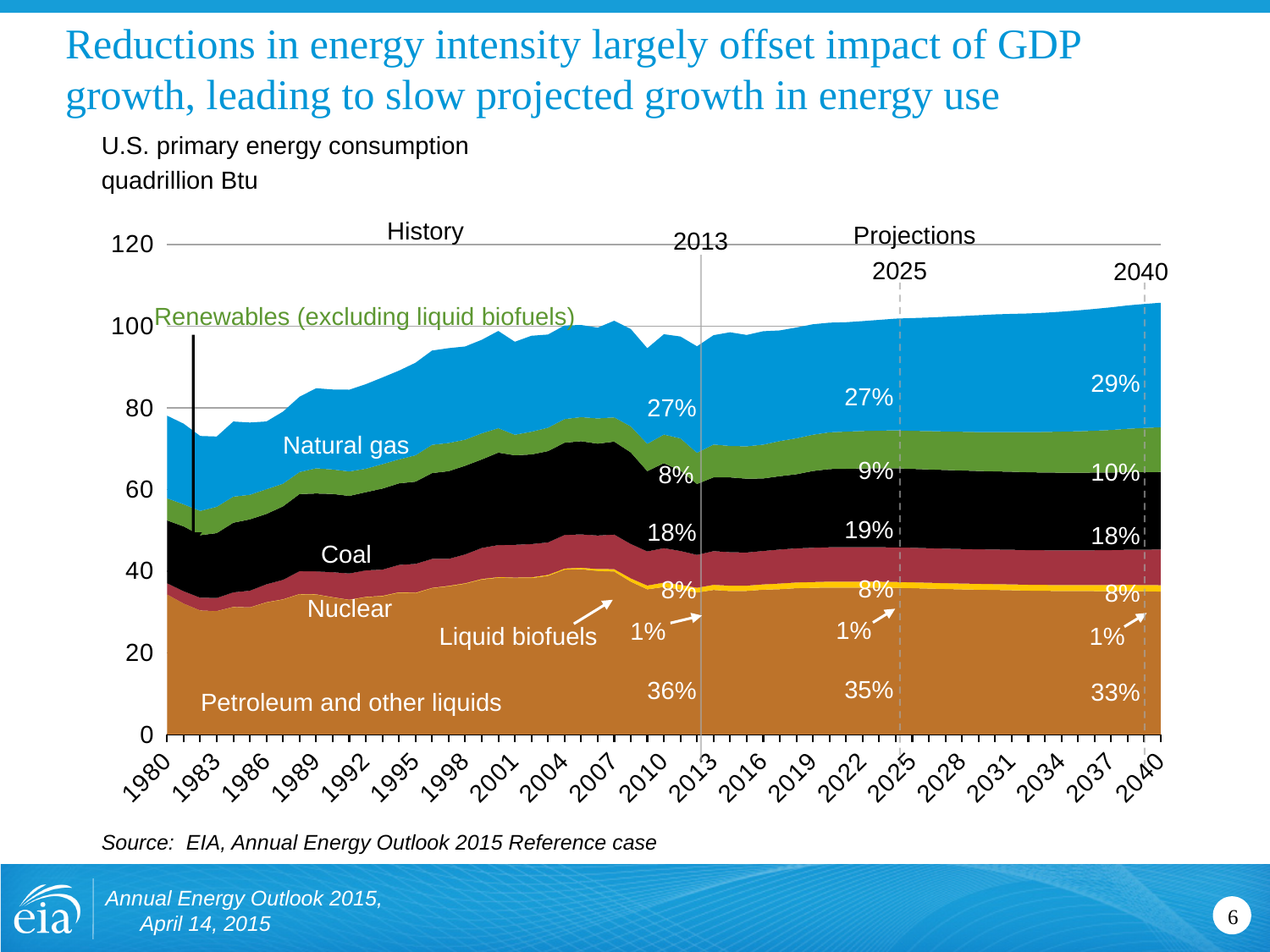
What share do renewables (excluding liquid biofuels) have in 2040? 10% What kind of chart is shown on the slide? Stacked area chart What share of U.S. primary energy consumption does petroleum and other liquids account for in 2013? 36% What share of U.S. primary energy consumption is natural gas projected to have in 2040? 29% By how many percentage points does the petroleum and other liquids share fall from 2013 to 2040? 3 percentage points Which fuel has the largest share of U.S. primary energy consumption in 2013? Petroleum and other liquids Which fuel has the smallest share of U.S. primary energy consumption in 2040? Liquid biofuels Is total U.S. primary energy consumption in 2040 greater or less than 100 quadrillion Btu? greater What is the coal share of U.S. primary energy consumption in 2025? 19% How many fuel categories are shown in the chart? 6 What is the liquid biofuels share of U.S. primary energy consumption in 2013? 1% In 2040, which is larger: the share of natural gas or the share of coal? Natural gas